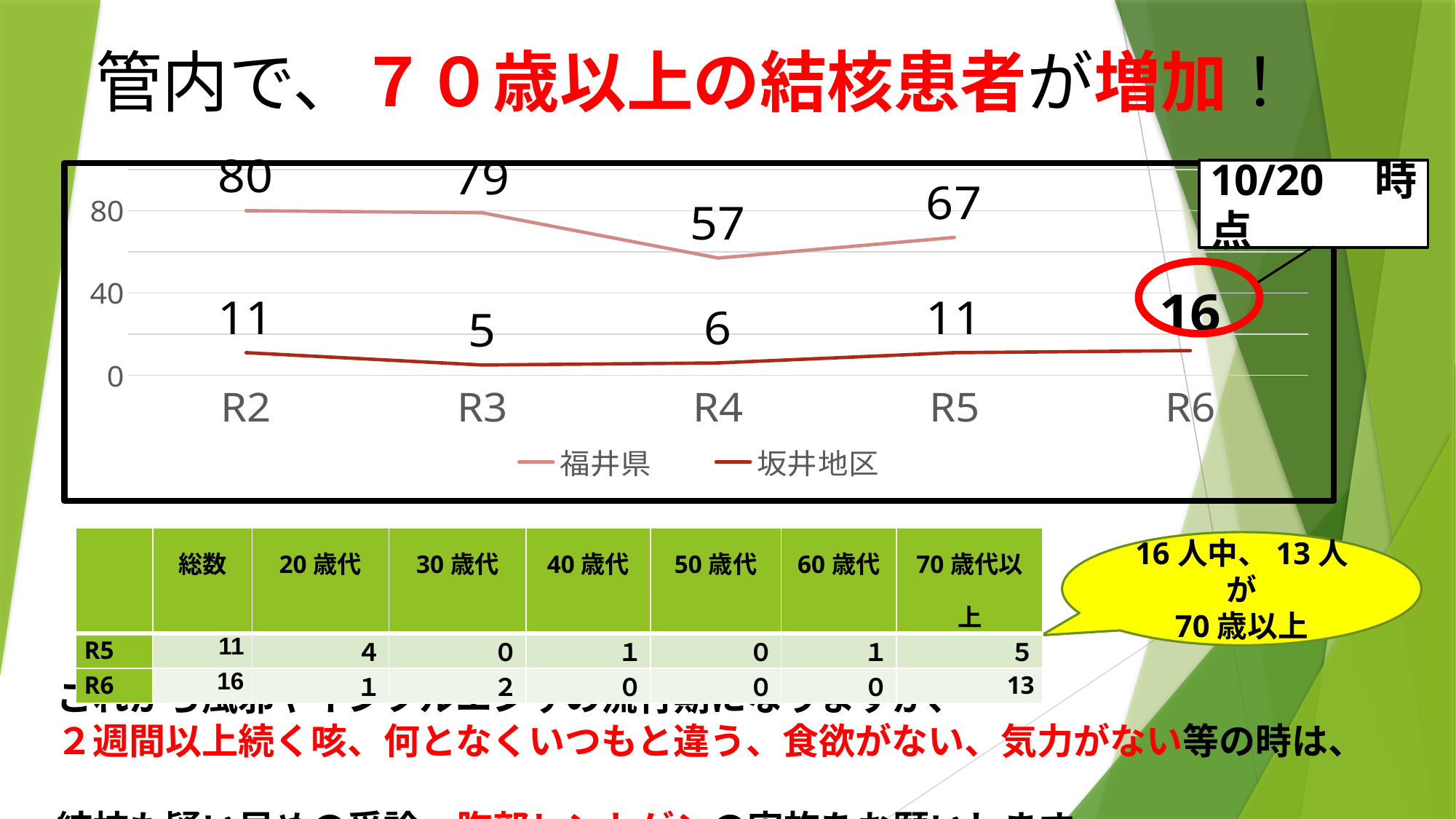
What is the value for 福井県 in R2? 80 In which year is the 福井県 value lowest? R4 What is the value for 福井県 in R4? 57 What is the difference between the 福井県 values in R2 and R4? 23 How many series does the chart legend list? 2 Does the 坂井地区 line rise or fall from R4 to R6? rise How many years are shown on the x axis of the chart? 5 What is the value for 坂井地区 in R6? 16 In which year is the 坂井地区 value highest? R6 What is the value for 坂井地区 in R3? 5 What kind of chart is shown on the slide? line chart Which is larger, the 坂井地区 value in R5 or in R6? R6